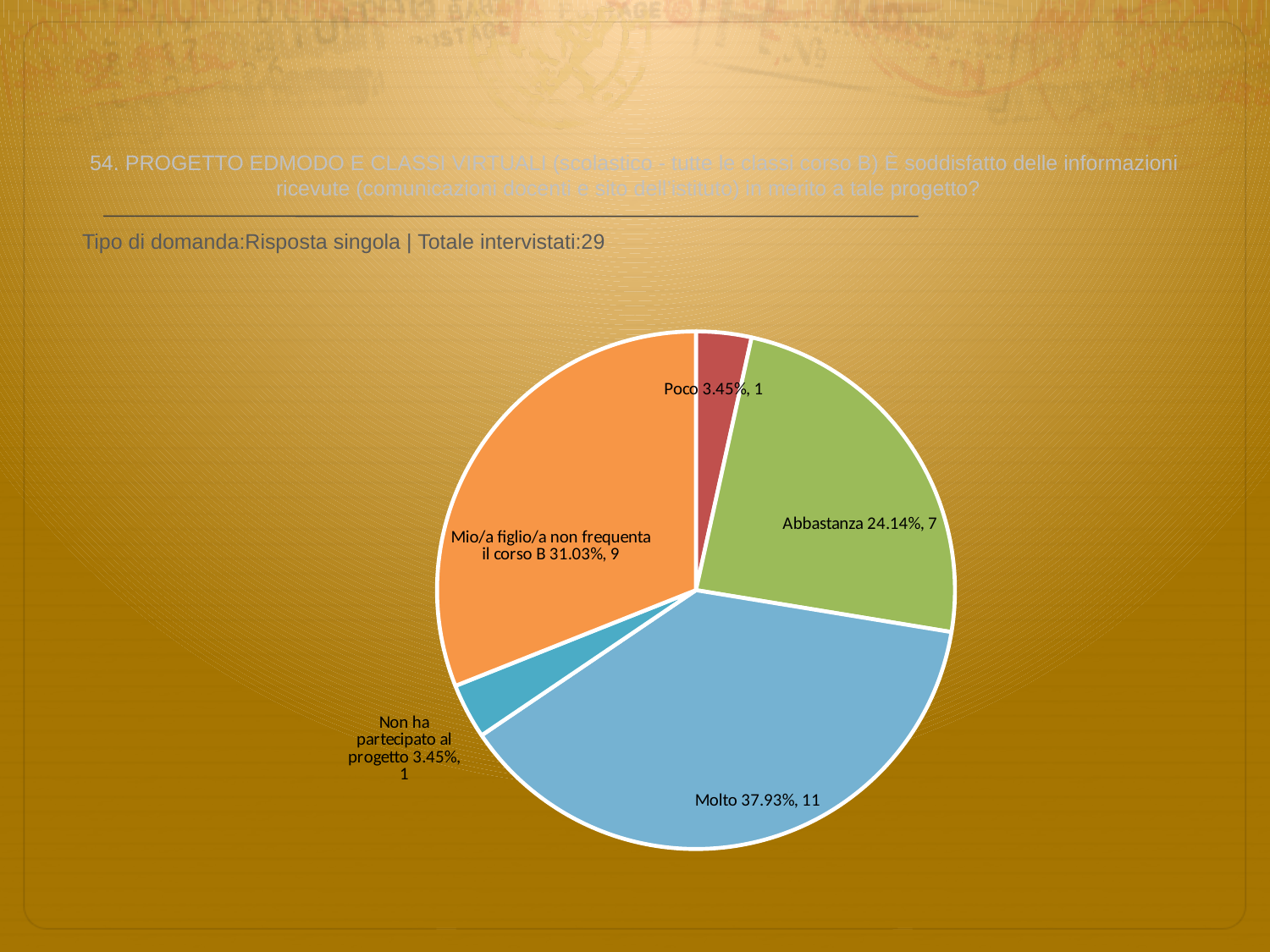
What colour is the 'Molto' slice? blue Which is larger, the 'Abbastanza' slice or the 'Mio/a figlio/a non frequenta il corso B' slice? Mio/a figlio/a non frequenta il corso B What percentage share does the 'Non ha partecipato al progetto' slice have? 3.45% How many slices does the pie chart have? 5 What percentage share does the 'Mio/a figlio/a non frequenta il corso B' slice have? 31.03% What is the total number of respondents stated on the slide? 29 What is the difference in respondent count between 'Molto' and 'Abbastanza'? 4 What kind of chart is shown on the slide? pie chart How many respondents answered 'Poco'? 1 How many respondents answered 'Abbastanza'? 7 Which category has the largest slice of the pie? Molto What percentage share does the 'Molto' slice have? 37.93%